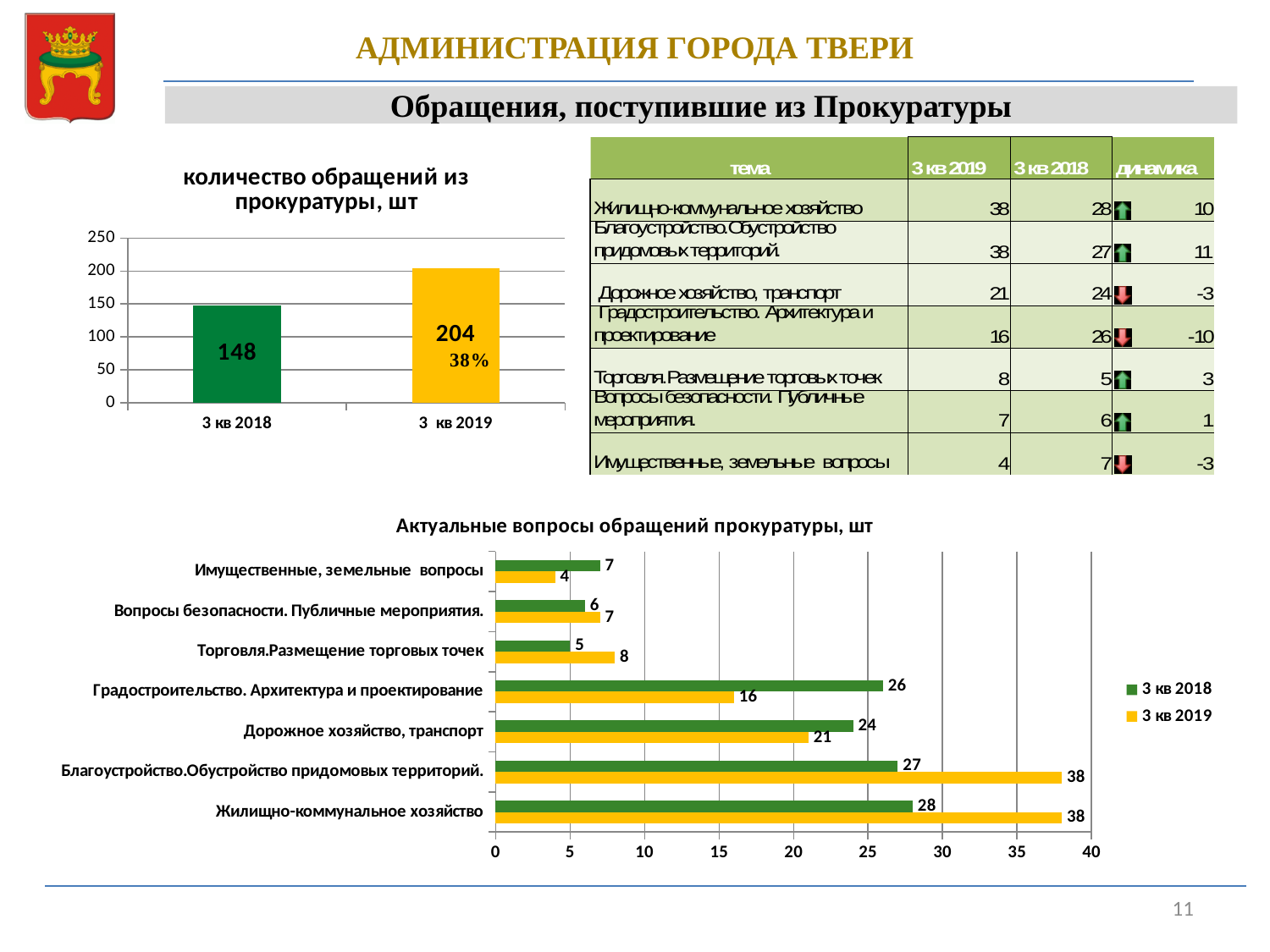
What kind of chart is 'Актуальные вопросы обращений прокуратуры, шт'? bar chart In the chart 'Актуальные вопросы обращений прокуратуры, шт', which category has the lowest 3 кв 2019 value? Имущественные, земельные вопросы In the chart 'Актуальные вопросы обращений прокуратуры, шт', which is larger for Торговля.Размещение торговых точек: 3 кв 2018 or 3 кв 2019? 3 кв 2019 In the chart 'количество обращений из прокуратуры, шт', what is the difference between the 3 кв 2019 and 3 кв 2018 values? 56 In the chart 'Актуальные вопросы обращений прокуратуры, шт', how many categories are shown? 7 In the chart 'количество обращений из прокуратуры, шт', what is the value for 3 кв 2019? 204 In the chart 'Актуальные вопросы обращений прокуратуры, шт', what is the 3 кв 2018 value for Дорожное хозяйство, транспорт? 24 In the chart 'количество обращений из прокуратуры, шт', what is the value for 3 кв 2018? 148 In the chart 'количество обращений из прокуратуры, шт', what percentage label is shown on the 3 кв 2019 bar? 38% In the chart 'Актуальные вопросы обращений прокуратуры, шт', how many series does the legend list? 2 In the chart 'Актуальные вопросы обращений прокуратуры, шт', what is the 3 кв 2019 value for Градостроительство. Архитектура и проектирование? 16 In the chart 'Актуальные вопросы обращений прокуратуры, шт', which category has the highest 3 кв 2018 value? Жилищно-коммунальное хозяйство